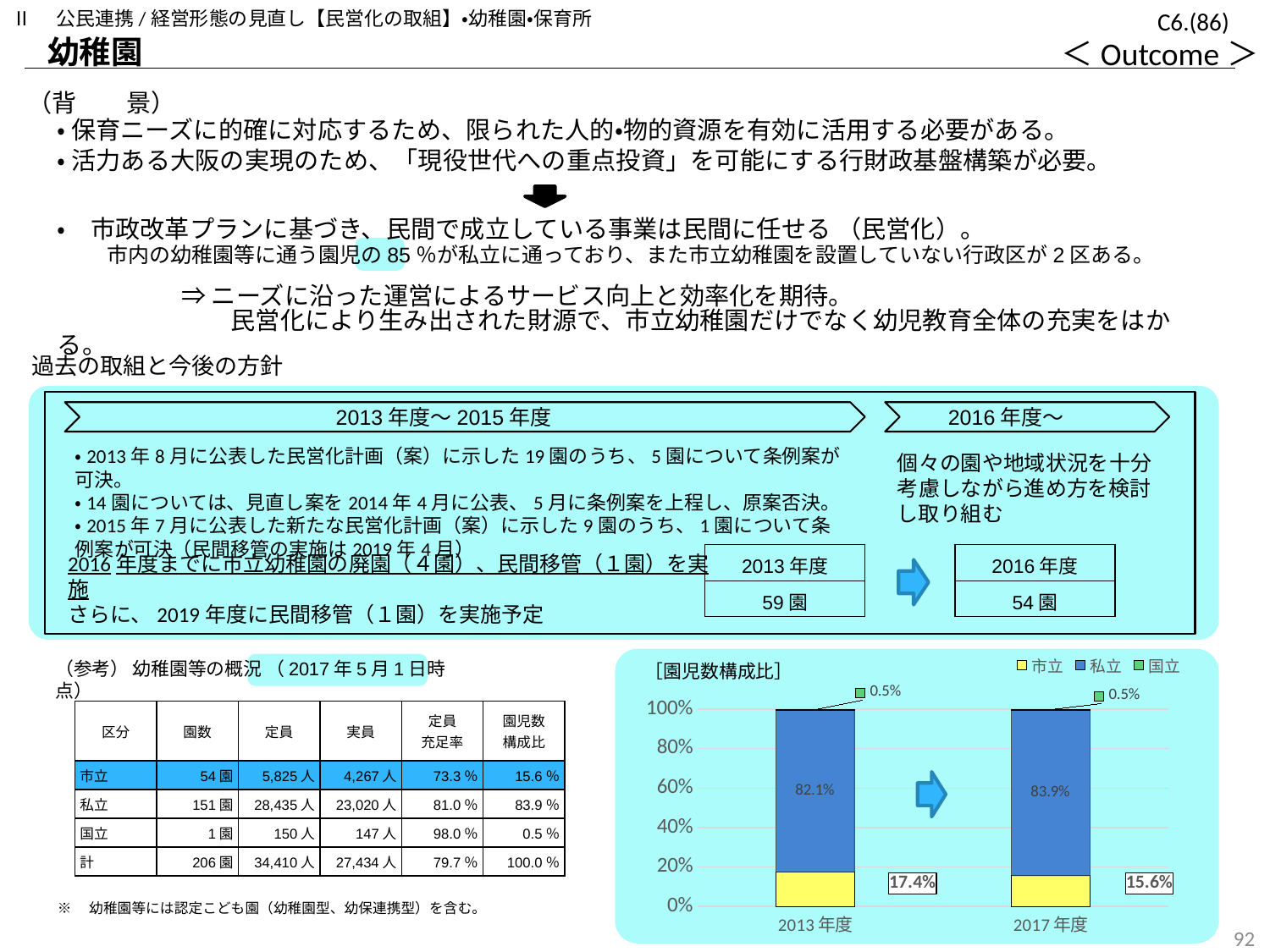
In the [園児数構成比] chart, what is the value for 市立 in 2013年度? 17.4% How many categories are shown on the x axis of the [園児数構成比] chart? 2 How many series does the legend of the [園児数構成比] chart list? 3 In the [園児数構成比] chart, what is the value for 私立 in 2017年度? 83.9% In the [園児数構成比] chart, what is the value for 市立 in 2017年度? 15.6% In the [園児数構成比] chart, which series has the largest share in 2017年度? 私立 What kind of chart is shown under the title [園児数構成比]? stacked bar chart In the [園児数構成比] chart, what is the difference between the 市立 values for 2013年度 and 2017年度? 1.8% In the [園児数構成比] chart, what is the value for 私立 in 2013年度? 82.1% In the [園児数構成比] chart, does the 市立 share rise or fall from 2013年度 to 2017年度? fall In the [園児数構成比] chart, which series has the smallest share in 2013年度? 国立 In the [園児数構成比] chart, what is the value for 国立 in 2013年度? 0.5%